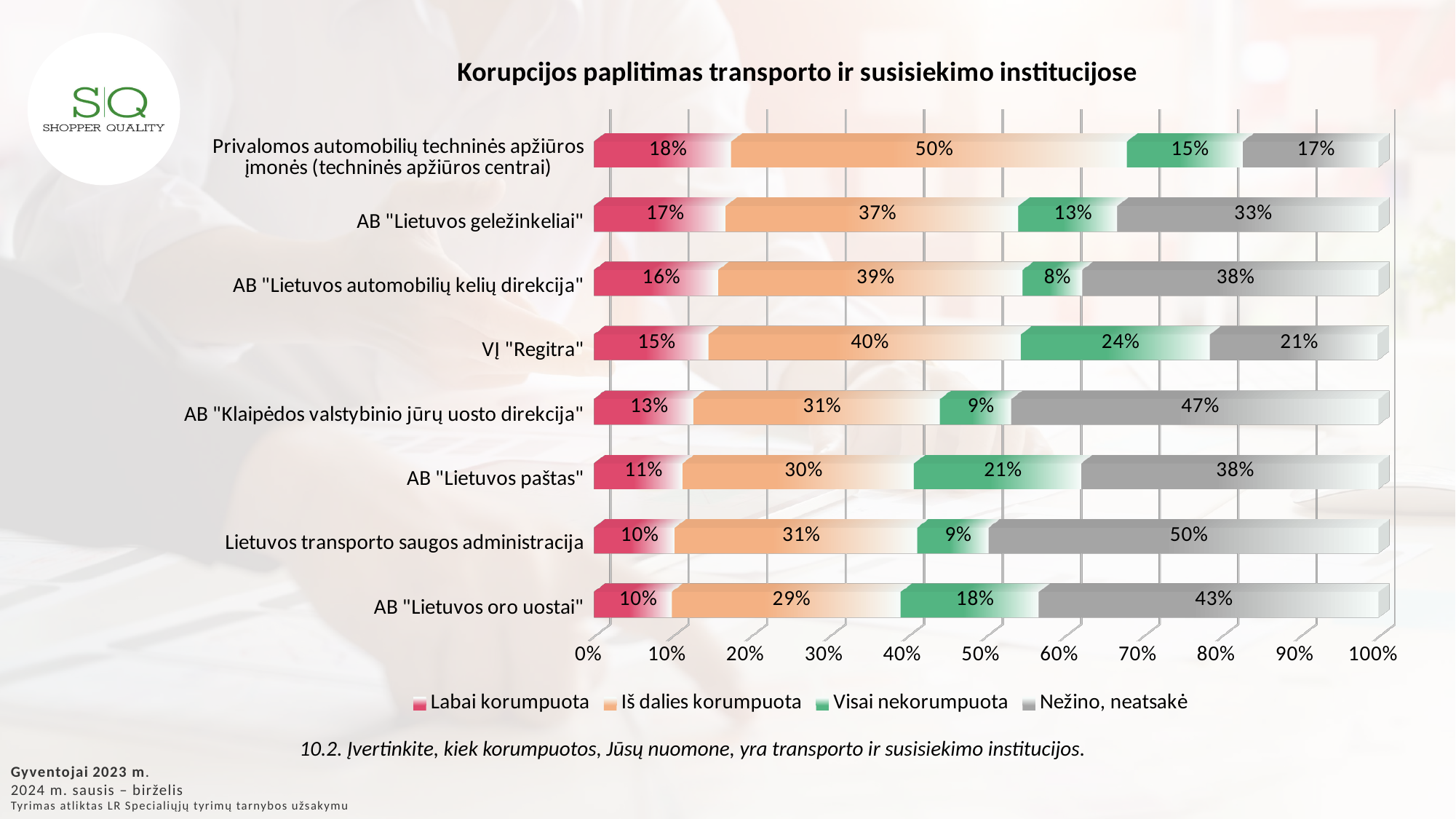
Which is larger: the "Iš dalies korumpuota" value for AB "Lietuvos paštas" or for AB "Lietuvos oro uostai"? AB "Lietuvos paštas" What is the "Visai nekorumpuota" value for VĮ "Regitra"? 24% What kind of chart is shown on the slide? Stacked bar chart What is the total of the stacked bar for AB "Lietuvos geležinkeliai"? 100% What is the difference between the "Nežino, neatsakė" values for Lietuvos transporto saugos administracija and AB "Lietuvos geležinkeliai"? 17% What is the title of the chart? Korupcijos paplitimas transporto ir susisiekimo institucijose What is the "Iš dalies korumpuota" value for Privalomos automobilių techninės apžiūros įmonės (techninės apžiūros centrai)? 50% Which institution has the highest "Labai korumpuota" value? Privalomos automobilių techninės apžiūros įmonės (techninės apžiūros centrai) Which institution has the lowest "Visai nekorumpuota" value? AB "Lietuvos automobilių kelių direkcija" How many institutions (categories) are shown in the chart? 8 What is the "Nežino, neatsakė" value for AB "Klaipėdos valstybinio jūrų uosto direkcija"? 47% How many series does the legend list? 4